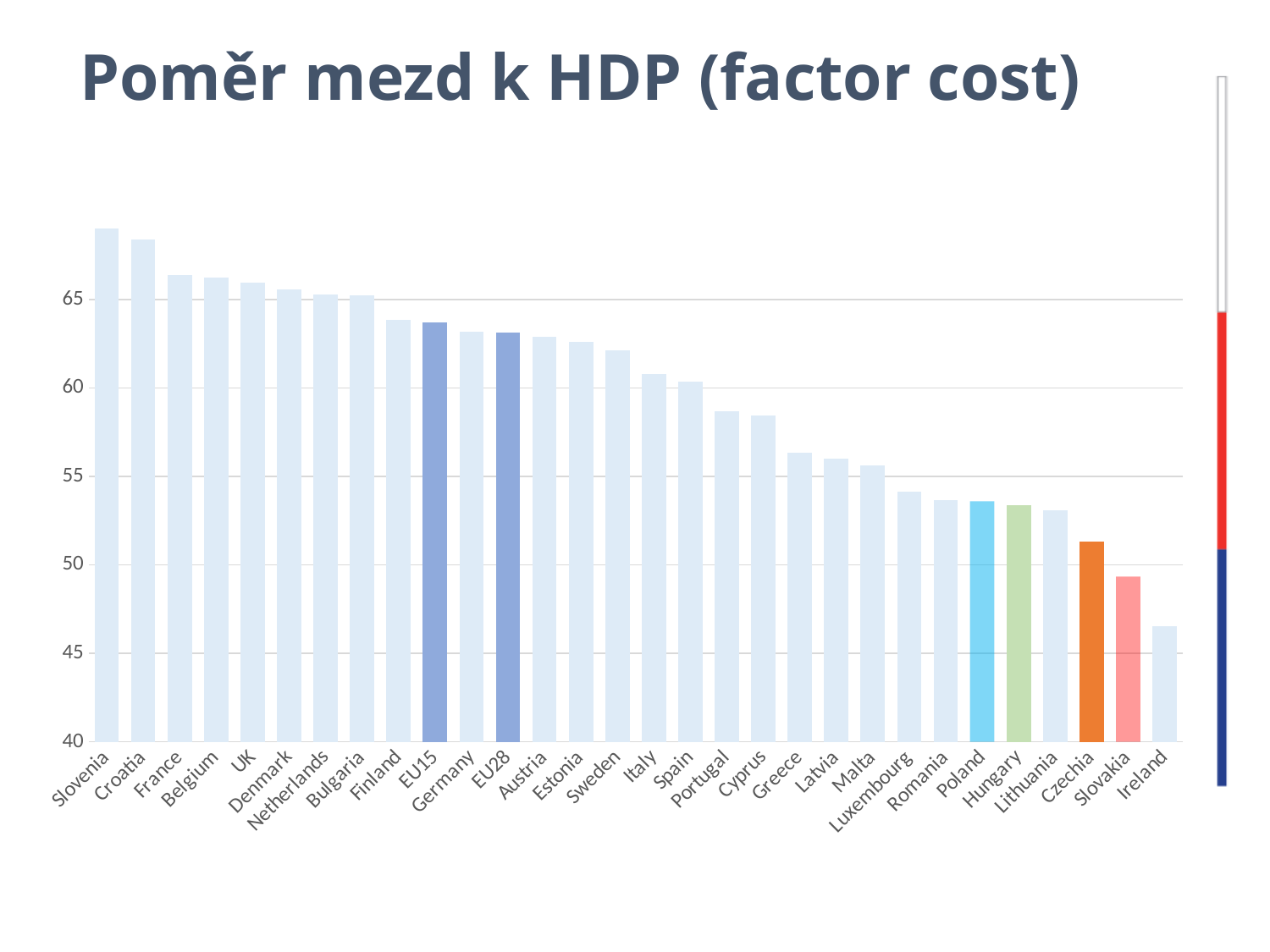
Do the values rise or fall moving from left to right along the x axis? fall What kind of chart is shown on the slide? bar chart Is the value for Germany greater or less than 60? greater What is the title of the chart? Poměr mezd k HDP (factor cost) Which category has the highest value? Slovenia Is the value for Ireland greater or less than 45? greater Which has the larger value, Poland or Ireland? Poland How many categories (bars) are shown on the chart? 30 Is the value for Czechia greater or less than 55? less Which has the larger value, Czechia or Slovakia? Czechia Which category has the lowest value? Ireland